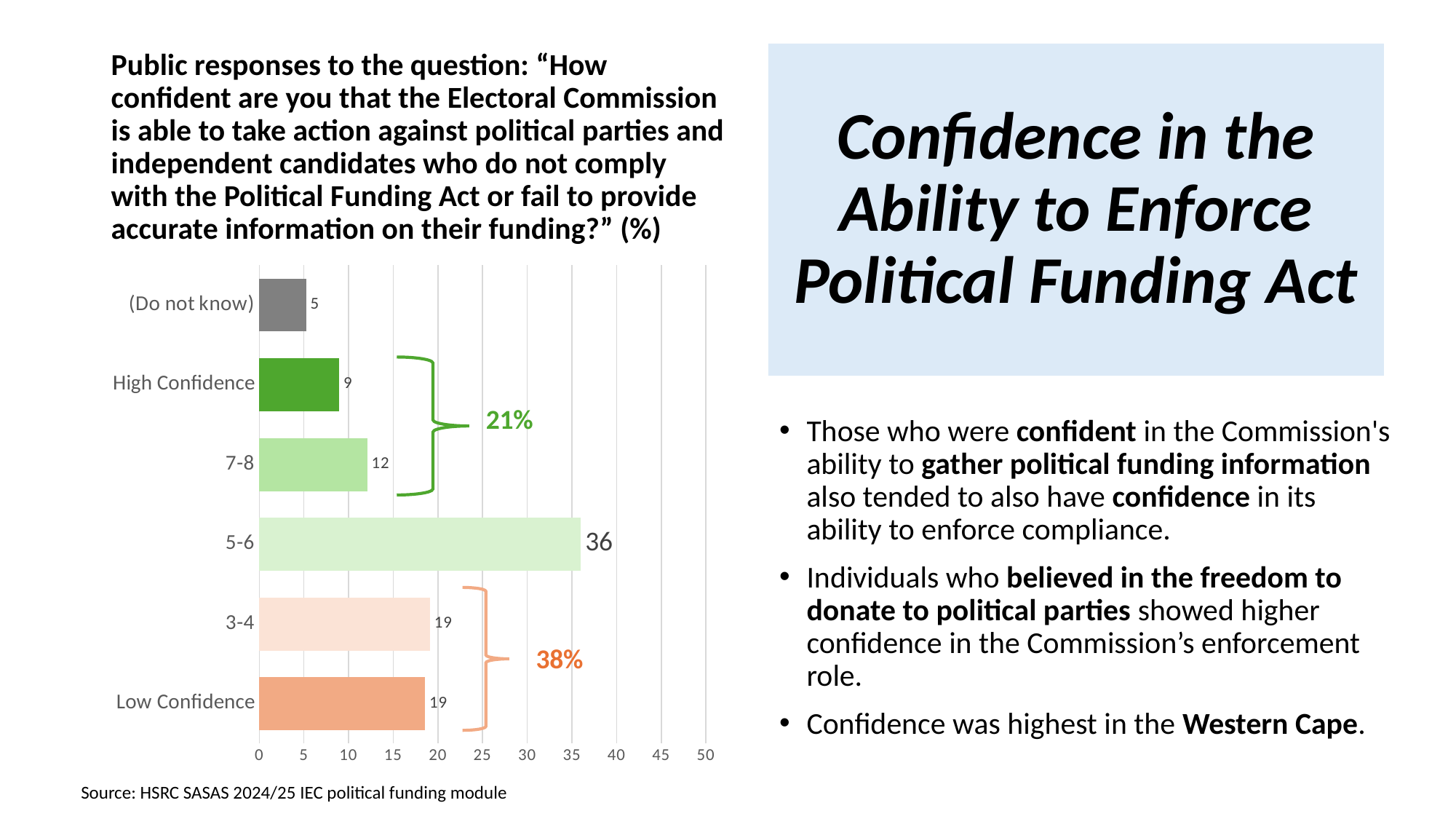
How many categories are shown on the chart? 6 Which is larger, the value for 7-8 or the value for High Confidence? 7-8 Which category has the lowest value? (Do not know) What is the difference between the values for 5-6 and 3-4? 17 Which category has the highest value? 5-6 What combined percentage is shown by the bracket grouping 3-4 and Low Confidence? 38% What combined percentage is shown by the bracket grouping High Confidence and 7-8? 21% What is the value for the 5-6 category? 36 What is the value for High Confidence? 9 What is the value for the 7-8 category? 12 What kind of chart is shown on the slide? Bar chart What is the value for the (Do not know) category? 5